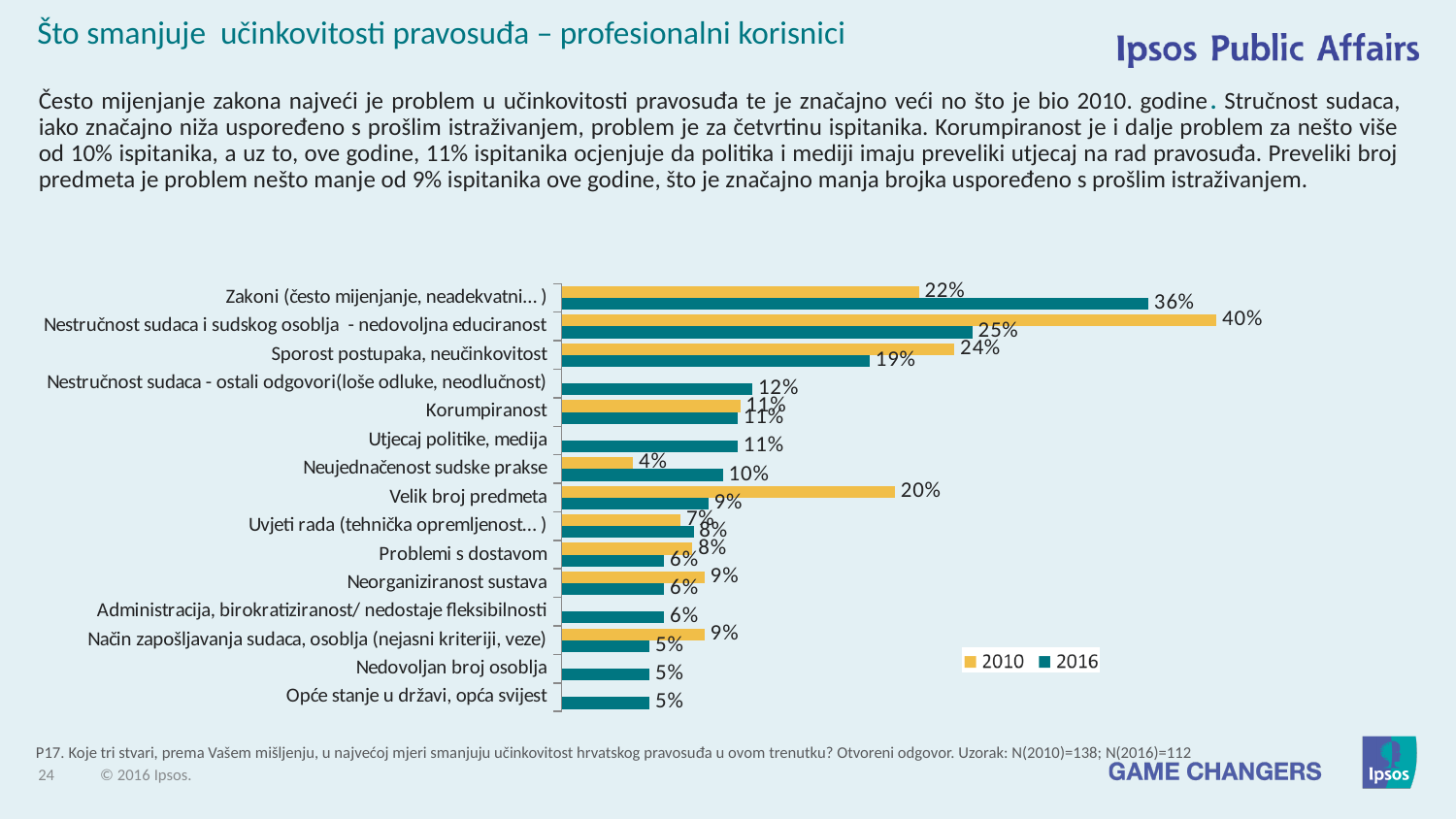
What is the 2016 value for 'Zakoni (često mijenjanje, neadekvatni… )'? 36% How many series does the legend list? 2 What is the 2010 value for 'Nestručnost sudaca i sudskog osoblja - nedovoljna educiranost'? 40% Which category has the highest 2016 value? Zakoni (često mijenjanje, neadekvatni… ) What is the difference between the 2016 and 2010 values for 'Zakoni (često mijenjanje, neadekvatni… )'? 14 percentage points For 'Sporost postupaka, neučinkovitost', which series has the larger value, 2010 or 2016? 2010 Which two series are listed in the legend? 2010 and 2016 How many categories are plotted on the chart? 15 What is the 2010 value for 'Velik broj predmeta'? 20% Which category has the highest 2010 value? Nestručnost sudaca i sudskog osoblja - nedovoljna educiranost What is the 2010 value for 'Neujednačenost sudske prakse'? 4% What kind of chart is shown on the slide? Bar chart